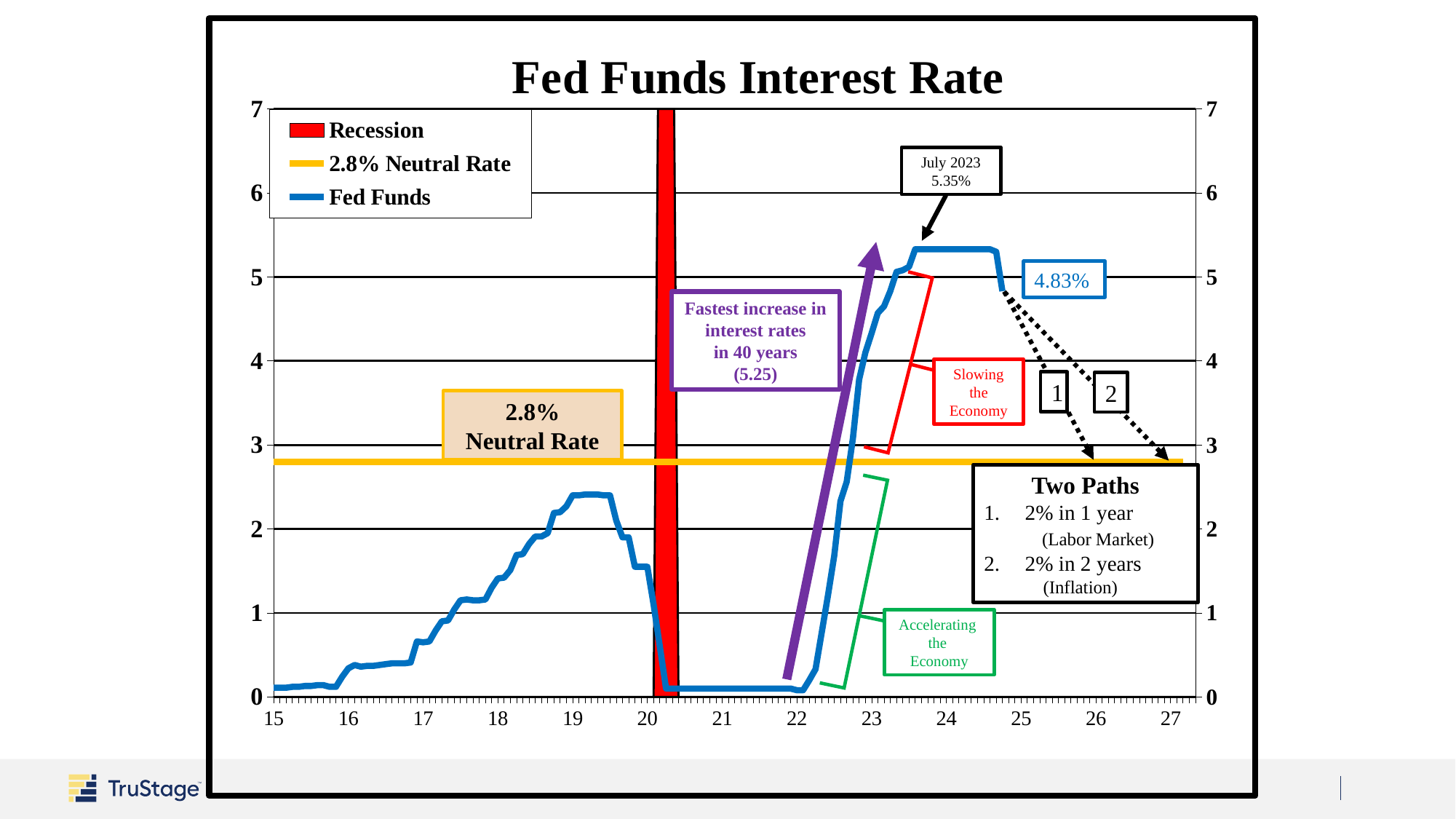
What is the title of the chart? Fed Funds Interest Rate Which is larger, the July 2023 rate or the later labeled rate of 4.83%? July 2023 (5.35%) What is the value of the neutral rate shown on the chart? 2.8% How many entries does the chart's legend list? 3 What is the difference between the July 2023 rate of 5.35% and the later labeled rate of 4.83%? 0.52% Does the Fed Funds line rise or fall between 22 and 23 on the x axis? rise What is the most recent Fed Funds value labeled on the chart, after the July 2023 peak? 4.83% According to the annotation, by how much did interest rates increase in the fastest increase in 40 years? 5.25 Is the Fed Funds rate at its 2019 peak greater or less than 3? less What Fed Funds rate is labeled for July 2023? 5.35% What kind of chart is shown on the slide? line chart What colour is the Fed Funds line on the chart? blue